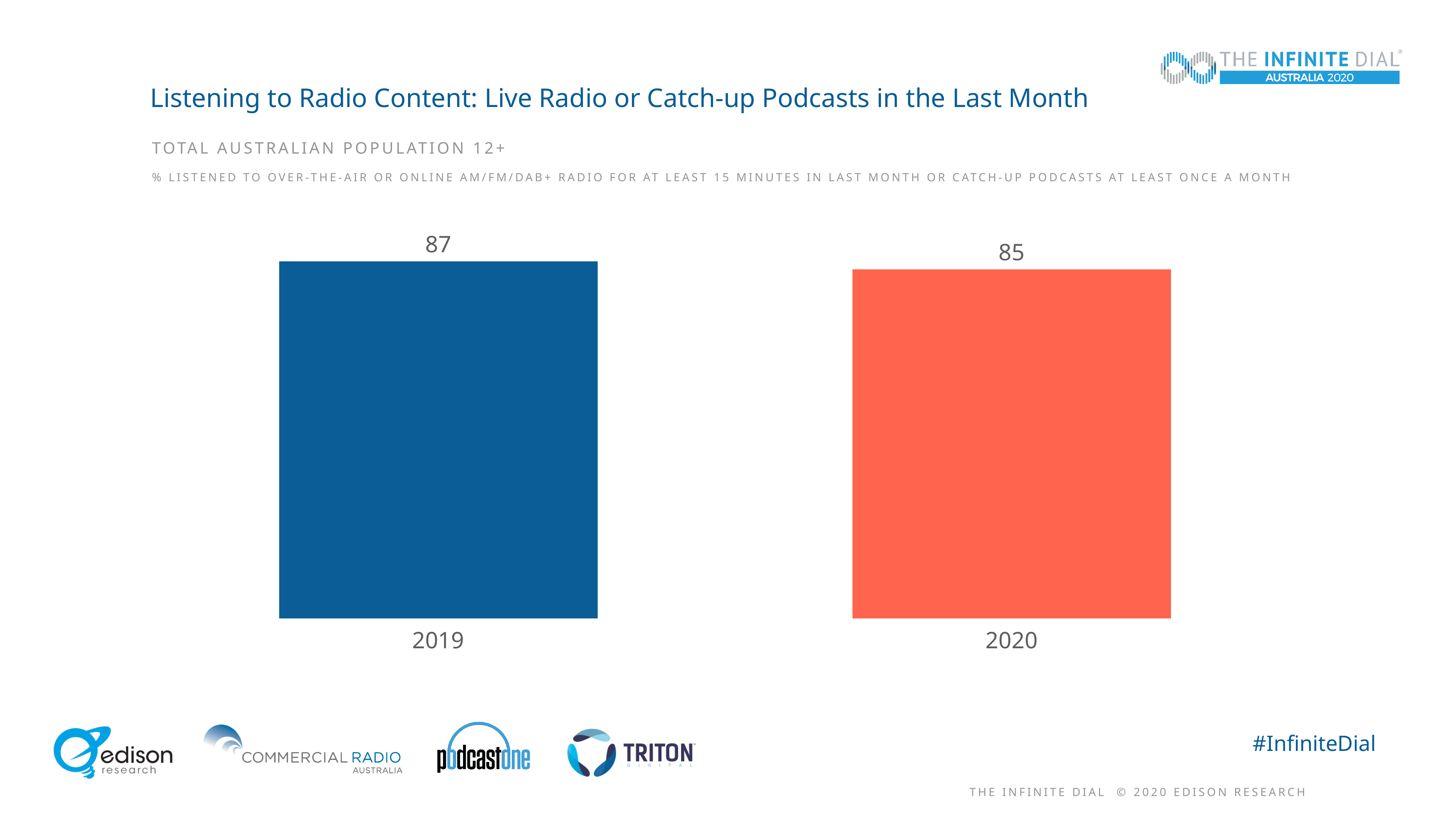
Which year has the lowest value? 2020 How many years are shown in the chart? 2 What is the value for 2020? 85 What colour is the bar for 2020? red What is the value for 2019? 87 What is the title of the chart? Listening to Radio Content: Live Radio or Catch-up Podcasts in the Last Month Which is larger, the value for 2019 or the value for 2020? 2019 Which year has the highest value? 2019 What kind of chart is shown on the slide? bar chart Do the values rise or fall from 2019 to 2020? fall What is the difference between the 2019 and 2020 values? 2